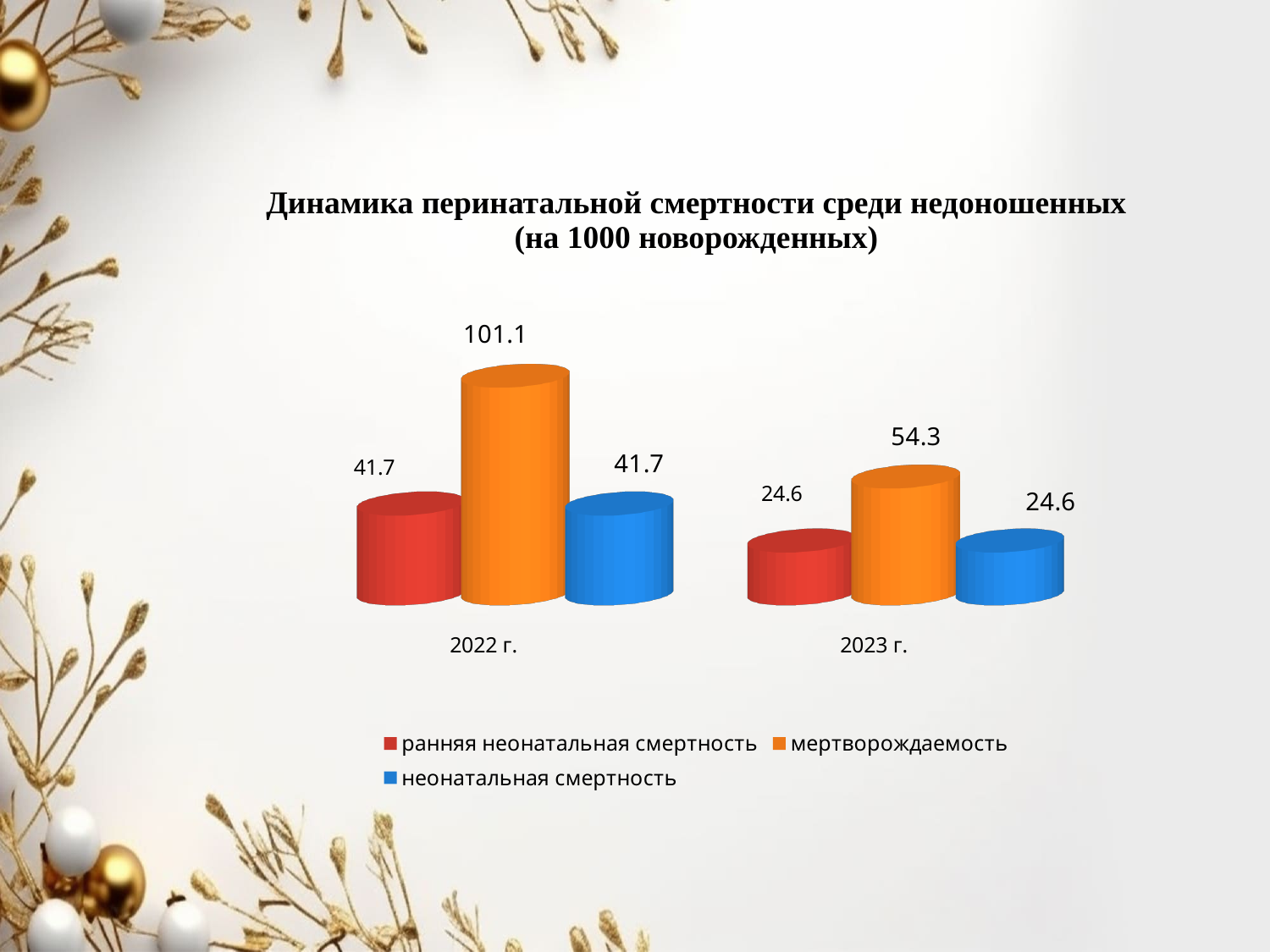
How many year categories are shown on the x axis? 2 Which series has the highest value in 2022 г.? мертворождаемость What is the value for ранняя неонатальная смертность in 2023 г.? 24.6 What is the difference between мертворождаемость in 2022 г. and in 2023 г.? 46.8 How many series does the legend list? 3 Which is larger: неонатальная смертность in 2022 г. or in 2023 г.? 2022 г. What kind of chart is shown on the slide? bar chart What is the value for мертворождаемость in 2022 г.? 101.1 Do the values for мертворождаемость rise or fall from 2022 г. to 2023 г.? fall What is the value for мертворождаемость in 2023 г.? 54.3 What is the difference between мертворождаемость and ранняя неонатальная смертность in 2023 г.? 29.7 What is the value for неонатальная смертность in 2022 г.? 41.7